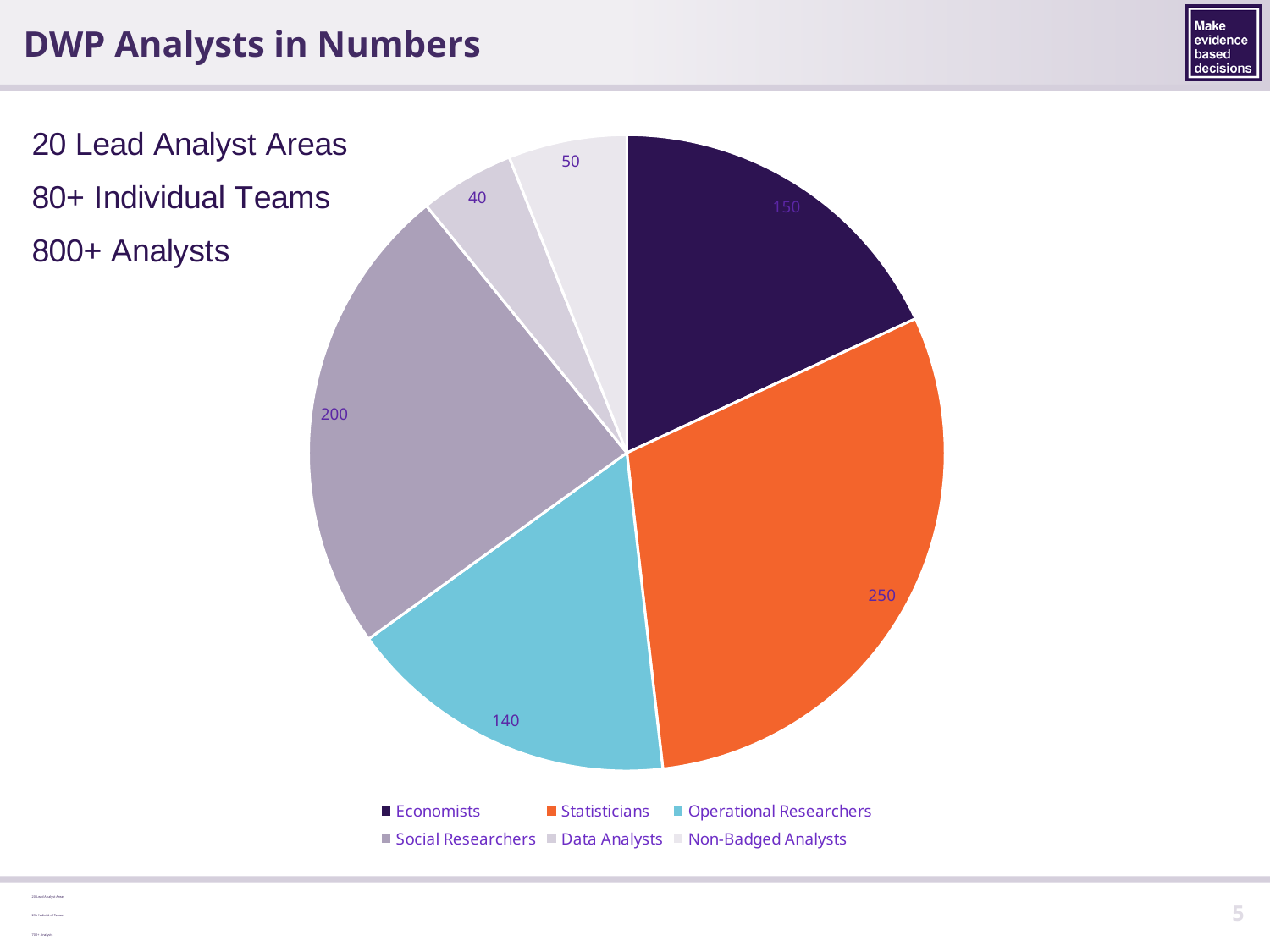
What is the value for Data Analysts in the pie chart? 40 How many Statisticians does the pie chart show? 250 What is the value for Economists in the pie chart? 150 What type of chart is shown on the slide? Pie chart Which category is shown in orange in the pie chart? Statisticians Which is larger, the value for Social Researchers or the value for Economists? Social Researchers What is the difference between the values for Economists and Operational Researchers? 10 Which category has the smallest slice of the pie chart? Data Analysts What is the value for Non-Badged Analysts in the pie chart? 50 How many categories does the pie chart have? 6 What is the difference between the values for Statisticians and Social Researchers? 50 Which category has the largest slice of the pie chart? Statisticians